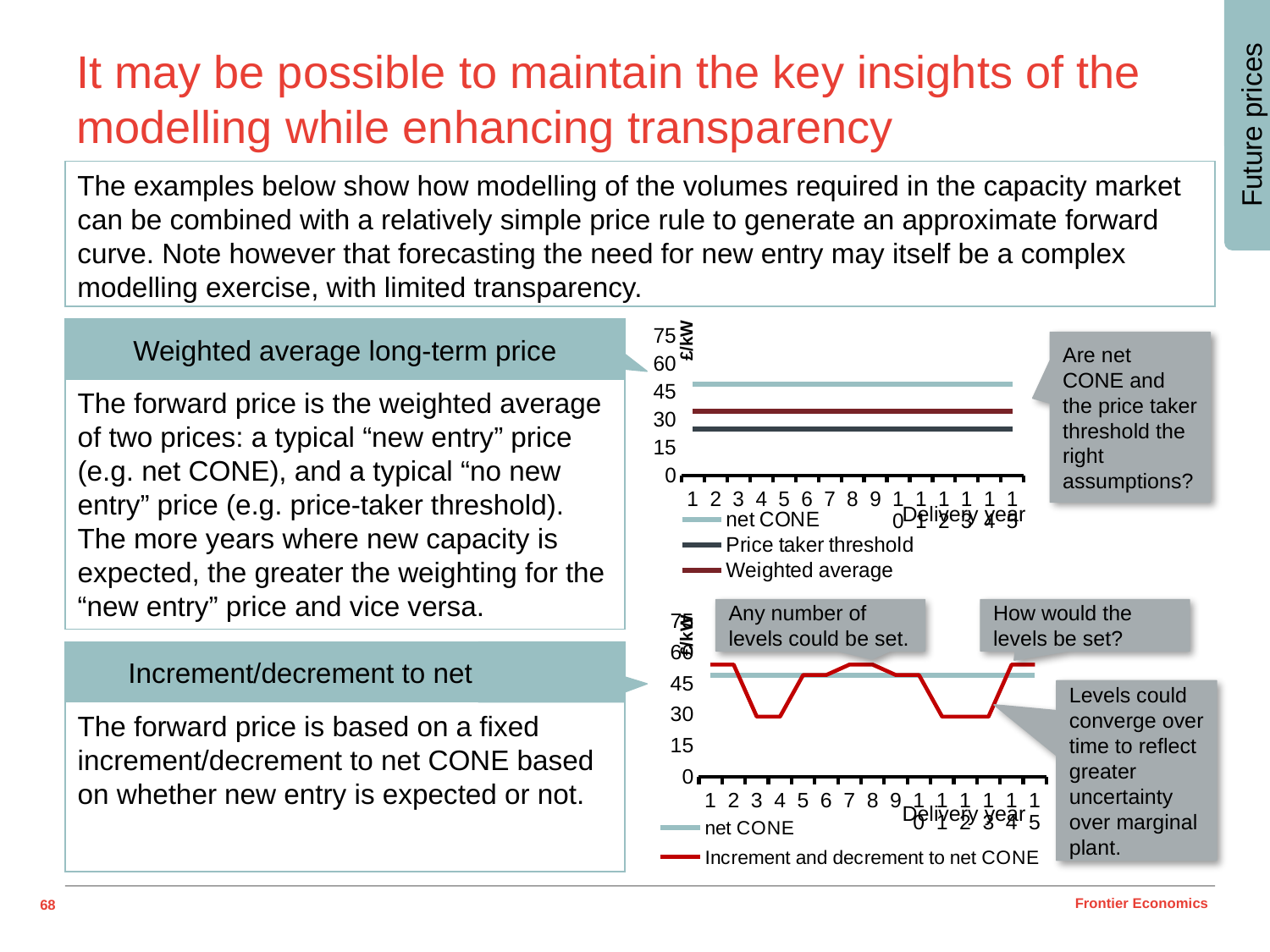
In the top chart, which is larger: the Weighted average or the Price taker threshold? Weighted average In the top chart, is the net CONE line greater or less than 30 £/kW? greater How many series does the legend of the bottom chart list? 2 How many series does the legend of the top chart list? 3 How many delivery years are shown on the x axis of the top chart? 15 In the top chart, which series has the lowest values? Price taker threshold What type of chart is the top chart on the slide? Line chart In the top chart, which series has the highest values? net CONE In the top chart, does the net CONE line rise, fall or stay flat across the delivery years? Stays flat What type of chart is the bottom chart on the slide? Line chart In the bottom chart, is the lowest value of the Increment and decrement to net CONE line greater or less than 45 £/kW? less In the top chart, is the Price taker threshold line greater or less than 45 £/kW? less